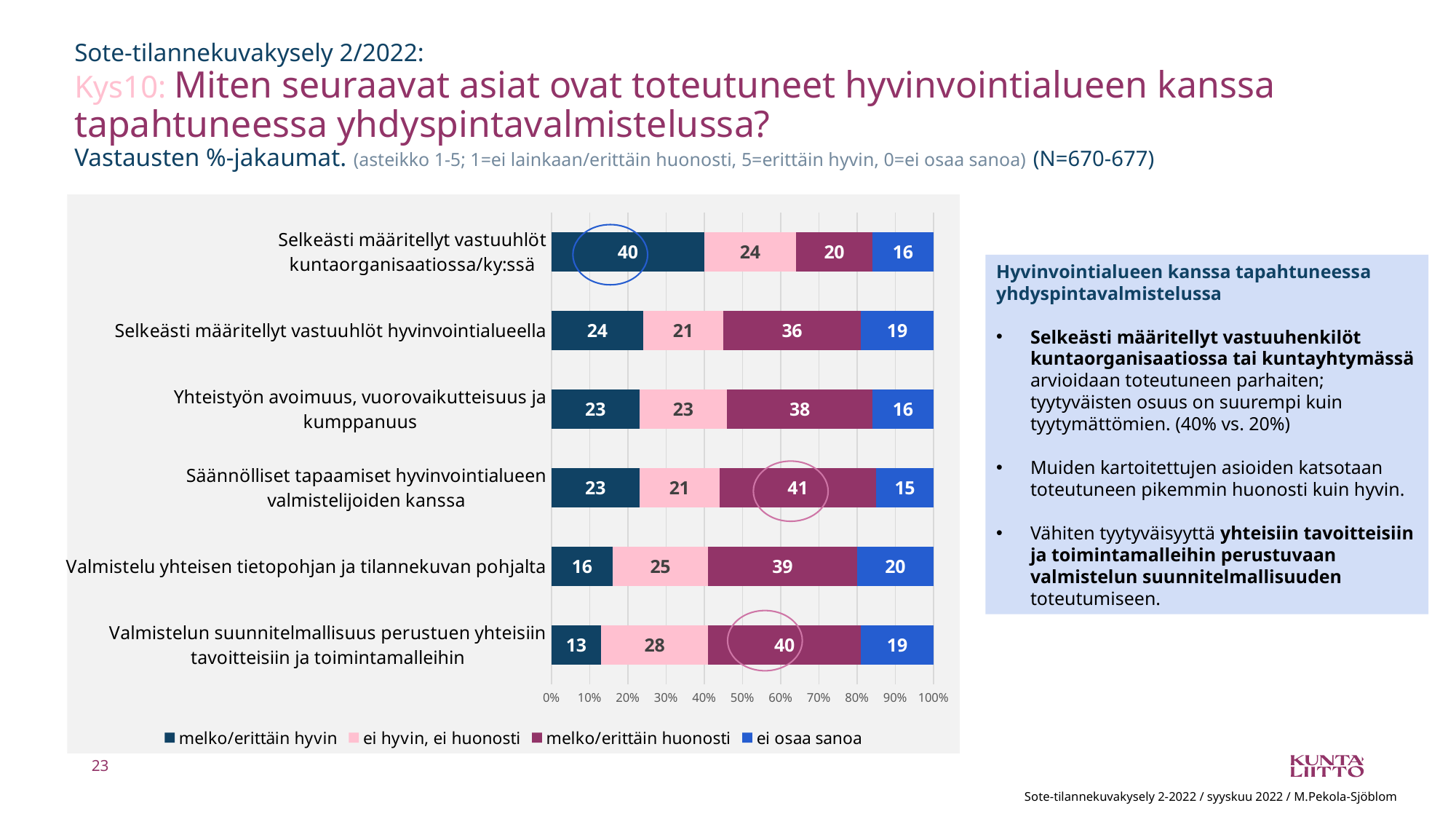
Which category has the highest "melko/erittäin hyvin" value? Selkeästi määritellyt vastuuhlöt kuntaorganisaatiossa/ky:ssä Which is larger for "Selkeästi määritellyt vastuuhlöt hyvinvointialueella": "melko/erittäin hyvin" or "melko/erittäin huonosti"? melko/erittäin huonosti Which legend entry is shown in light pink? ei hyvin, ei huonosti What is the value of "ei osaa sanoa" for "Valmistelu yhteisen tietopohjan ja tilannekuvan pohjalta"? 20 What is the difference between the "melko/erittäin hyvin" and "melko/erittäin huonosti" values for "Selkeästi määritellyt vastuuhlöt kuntaorganisaatiossa/ky:ssä"? 20 Which category has the lowest "melko/erittäin hyvin" value? Valmistelun suunnitelmallisuus perustuen yhteisiin tavoitteisiin ja toimintamalleihin What is the value of "melko/erittäin hyvin" for "Selkeästi määritellyt vastuuhlöt kuntaorganisaatiossa/ky:ssä"? 40 What kind of chart is shown on the slide? Stacked bar chart How many series does the legend list? 4 What is the total of the stacked bar for "Yhteistyön avoimuus, vuorovaikutteisuus ja kumppanuus"? 100 What is the value of "melko/erittäin huonosti" for "Säännölliset tapaamiset hyvinvointialueen valmistelijoiden kanssa"? 41 How many categories are shown on the chart? 6